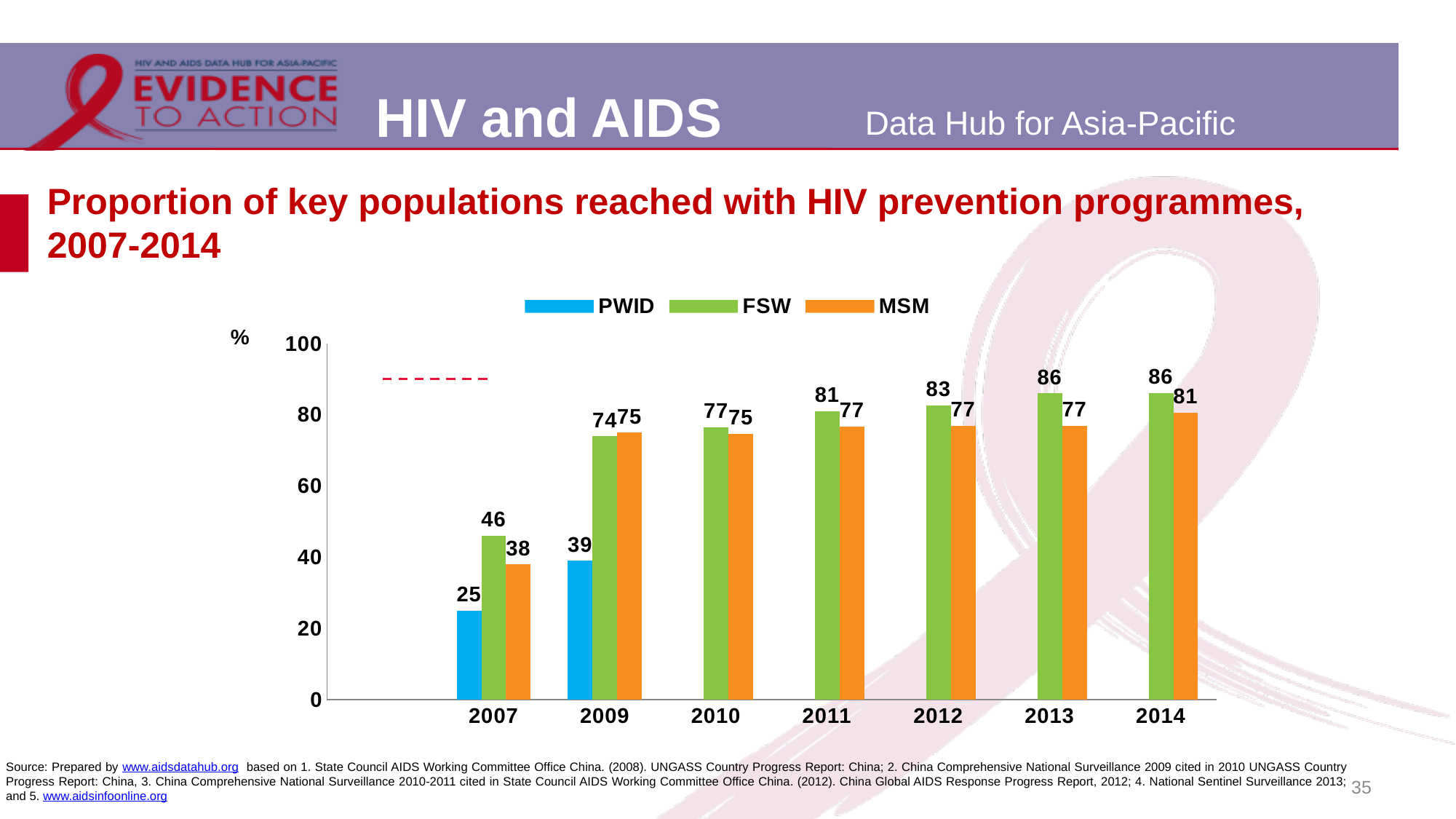
How many years are shown on the x axis? 7 Which is larger in 2009, the FSW value or the MSM value? MSM How many series does the legend list? 3 What is the value for FSW in 2007? 46 Which colour represents PWID in the legend? blue What is the value for MSM in 2014? 81 Is the value for FSW in 2013 greater or less than 80? greater In which year is the MSM value lowest? 2007 What kind of chart is shown on the slide? bar chart Does the FSW value rise or fall from 2007 to 2014? rise What is the difference between the FSW and MSM values in 2007? 8 What is the value for PWID in 2009? 39